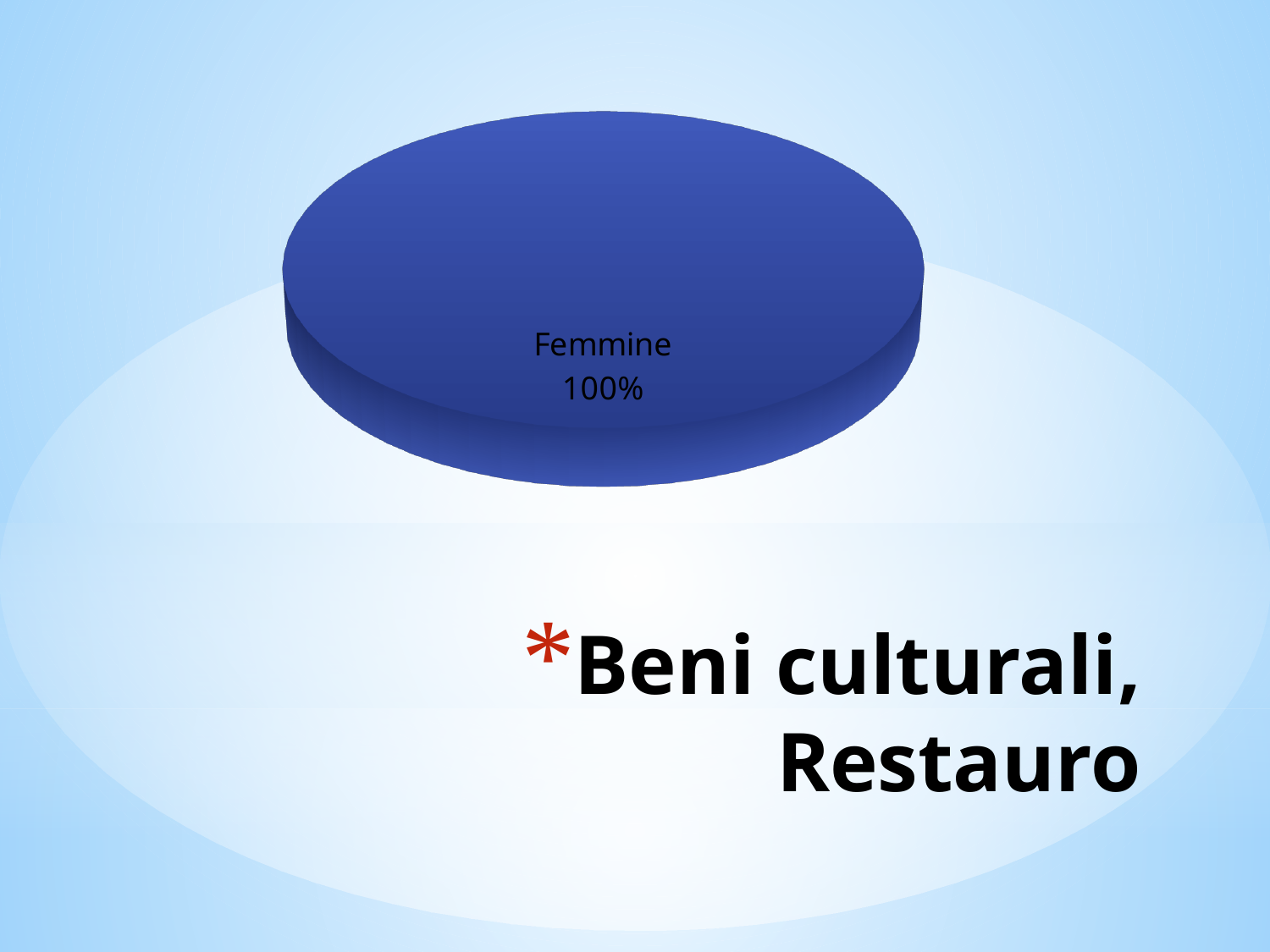
What share of the pie does Femmine account for? 100% What colour is the Femmine slice? blue Which category is the largest slice of the pie? Femmine What is the label of the only slice in the pie chart? Femmine What is the value shown for Femmine? 100% How many slices does the pie chart have? 1 What kind of chart is shown on the slide? pie chart Is the value for Femmine greater or less than 50%? greater